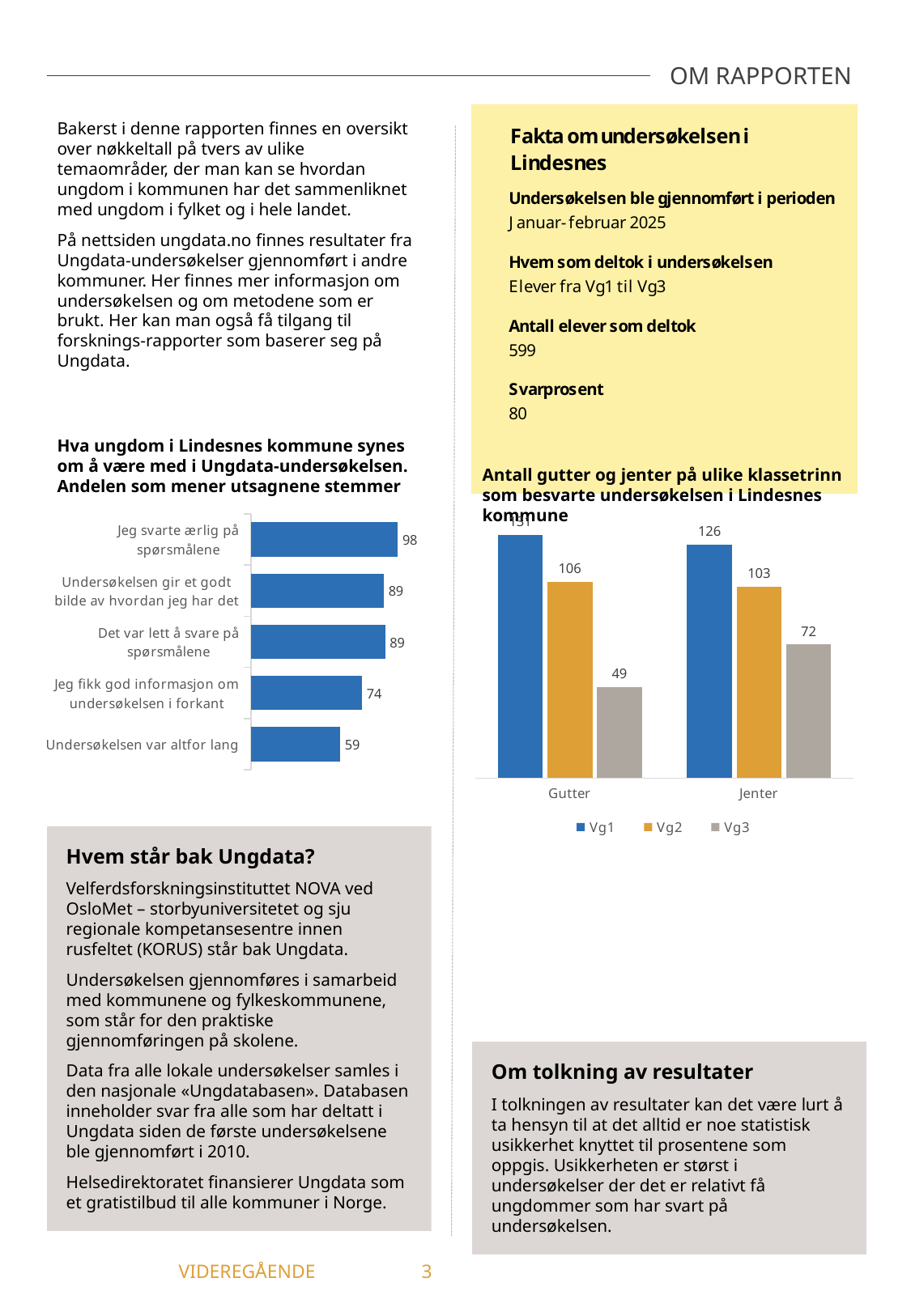
In the right chart of boys and girls by grade level who answered the survey, which is larger: Vg2 for Gutter or Vg2 for Jenter? Vg2 for Gutter What type of chart is the left chart about what youth in Lindesnes think of participating in the Ungdata survey? Bar chart In the left chart about what youth in Lindesnes think of participating in the Ungdata survey, which statement has the highest value? Jeg svarte ærlig på spørsmålene In the left chart about what youth in Lindesnes think of participating in the Ungdata survey, what is the value for "Undersøkelsen var altfor lang"? 59 In the right chart of boys and girls by grade level who answered the survey, what is the value for Vg3 among Jenter? 72 In the left chart about what youth in Lindesnes think of participating in the Ungdata survey, what is the difference between "Jeg svarte ærlig på spørsmålene" and "Jeg fikk god informasjon om undersøkelsen i forkant"? 24 How many series does the legend of the right chart of boys and girls by grade level list? 3 In the left chart about what youth in Lindesnes think of participating in the Ungdata survey, what is the value for "Jeg svarte ærlig på spørsmålene"? 98 In the left chart about what youth in Lindesnes think of participating in the Ungdata survey, how many statements are shown? 5 In the left chart about what youth in Lindesnes think of participating in the Ungdata survey, which statement has the lowest value? Undersøkelsen var altfor lang In the right chart of boys and girls by grade level who answered the survey, what is the value for Vg2 among Gutter? 106 In the right chart of boys and girls by grade level who answered the survey, what is the difference between Vg3 for Jenter and Vg3 for Gutter? 23